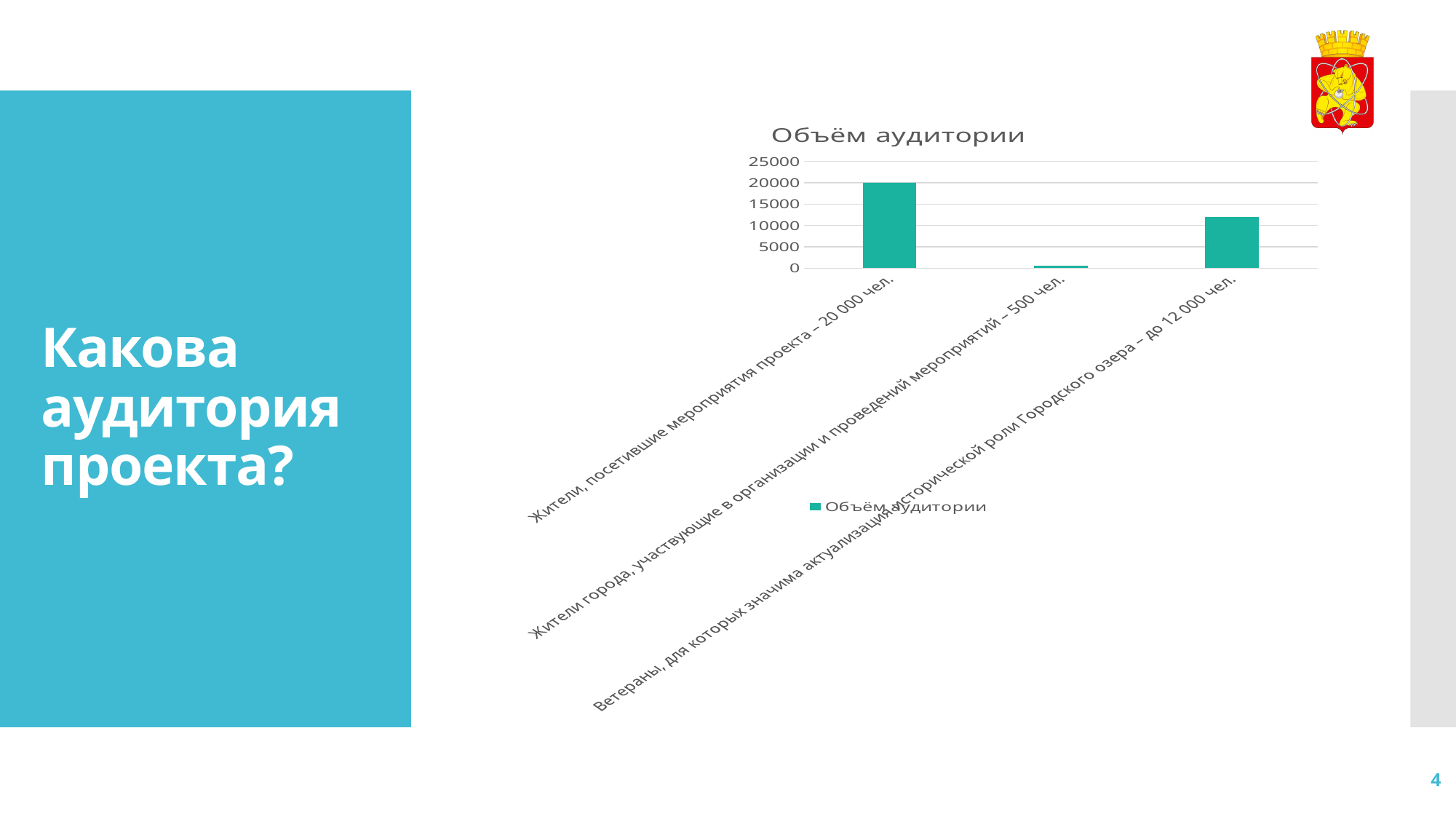
Is the value for residents participating in organising events greater or less than 5000? less According to its category label, how many residents participate in organising and holding events? 500 чел. Is the value for veterans (Ветераны, для которых значима актуализация исторической роли Городского озера) greater or less than 10000? greater What is the value for residents who attended project events (Жители, посетившие мероприятия проекта)? 20000 How many categories are plotted in the chart? 3 How many series does the legend list? 1 What colour are the bars in the chart? teal What kind of chart is shown on the slide? bar chart Which category has the highest value in the chart? Жители, посетившие мероприятия проекта – 20 000 чел. Which category has the lowest value in the chart? Жители города, участвующие в организации и проведений мероприятий – 500 чел. What is the title of the chart? Объём аудитории Which is larger: the value for residents who attended project events or the value for veterans? residents who attended project events